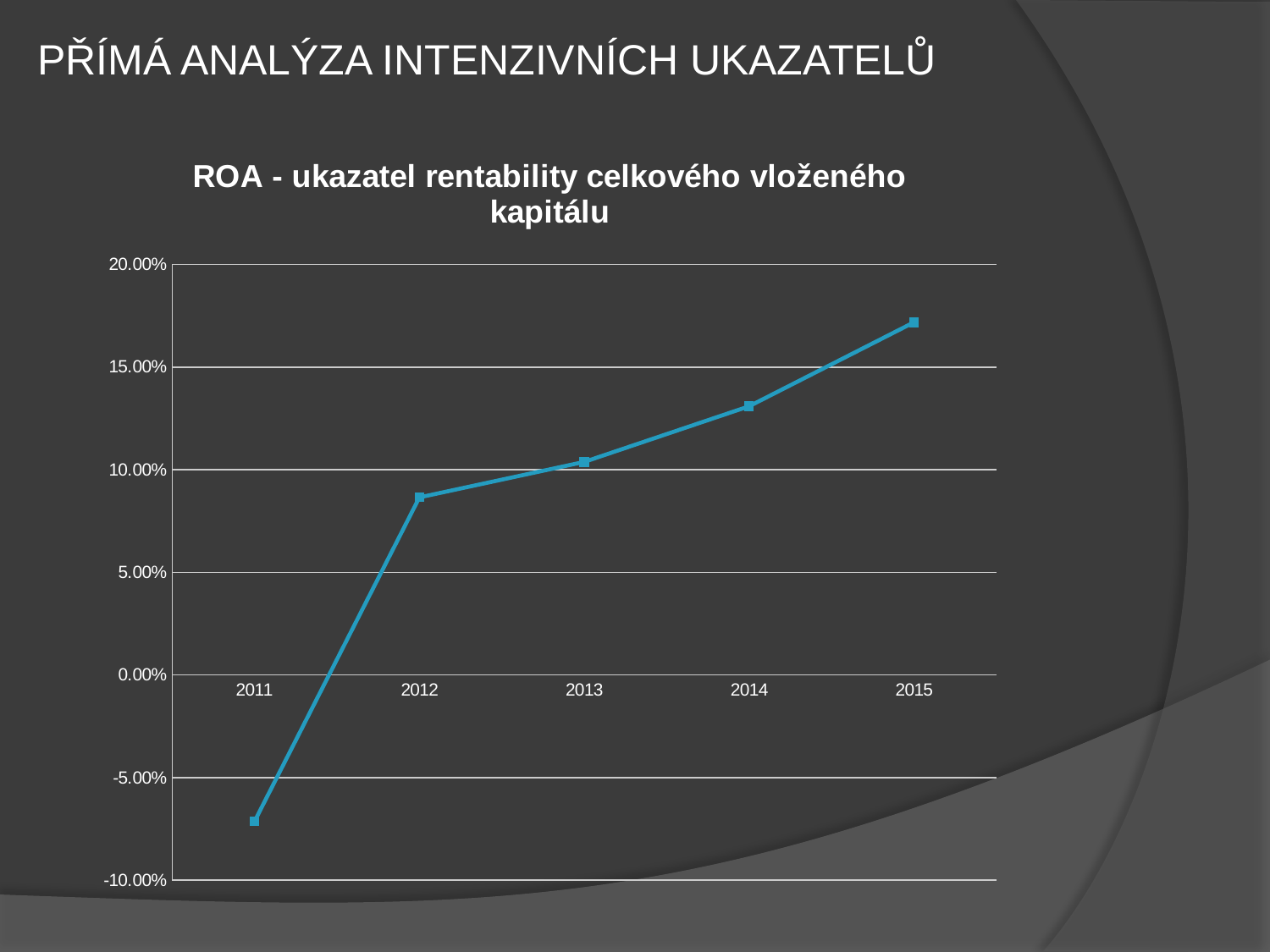
What kind of chart is shown on the slide? line chart Is the ROA value for 2014 greater or less than 10.00%? greater What is the title of the chart? ROA - ukazatel rentability celkového vloženého kapitálu Which year has the lowest ROA value? 2011 Is the ROA value for 2012 greater or less than 10.00%? less Is the ROA value for 2011 greater or less than 0.00%? less Do the ROA values rise or fall from 2011 to 2015? rise How many years are plotted on the x axis of the chart? 5 Which year has the highest ROA value? 2015 Which year has the larger ROA value, 2012 or 2014? 2014